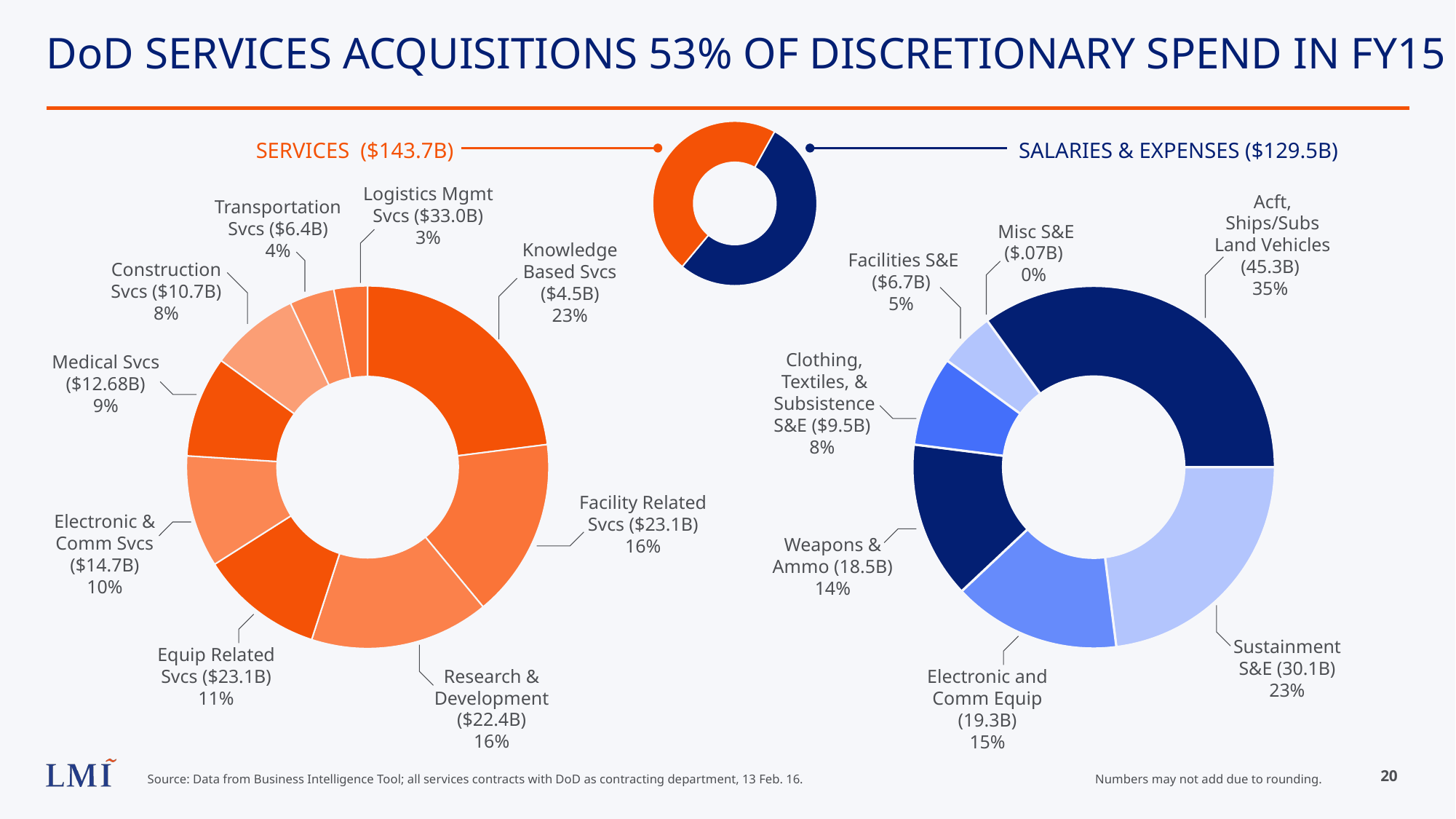
In the Salaries & Expenses chart, which category has the largest share? Acft, Ships/Subs Land Vehicles (35%) In the Services chart, what is the value shown for Medical Svcs? $12.68B In the small center chart, which is larger: Services or Salaries & Expenses? Services ($143.7B) In the Salaries & Expenses chart, what is the value shown for Weapons & Ammo? 18.5B How many categories are shown in the Salaries & Expenses chart? 7 What kind of chart is the Services chart on the left of the slide? donut (pie) chart In the Services chart, what share does Facility Related Svcs account for? 16% How many categories are shown in the Services chart? 9 In the Salaries & Expenses chart, which category has the smallest share? Misc S&E (0%) In the small center chart, what is the difference between Services ($143.7B) and Salaries & Expenses ($129.5B)? $14.2B In the small center chart, what colour represents Services? Orange In the Salaries & Expenses chart, what is the difference between Sustainment S&E (30.1B) and Electronic and Comm Equip (19.3B)? 10.8B